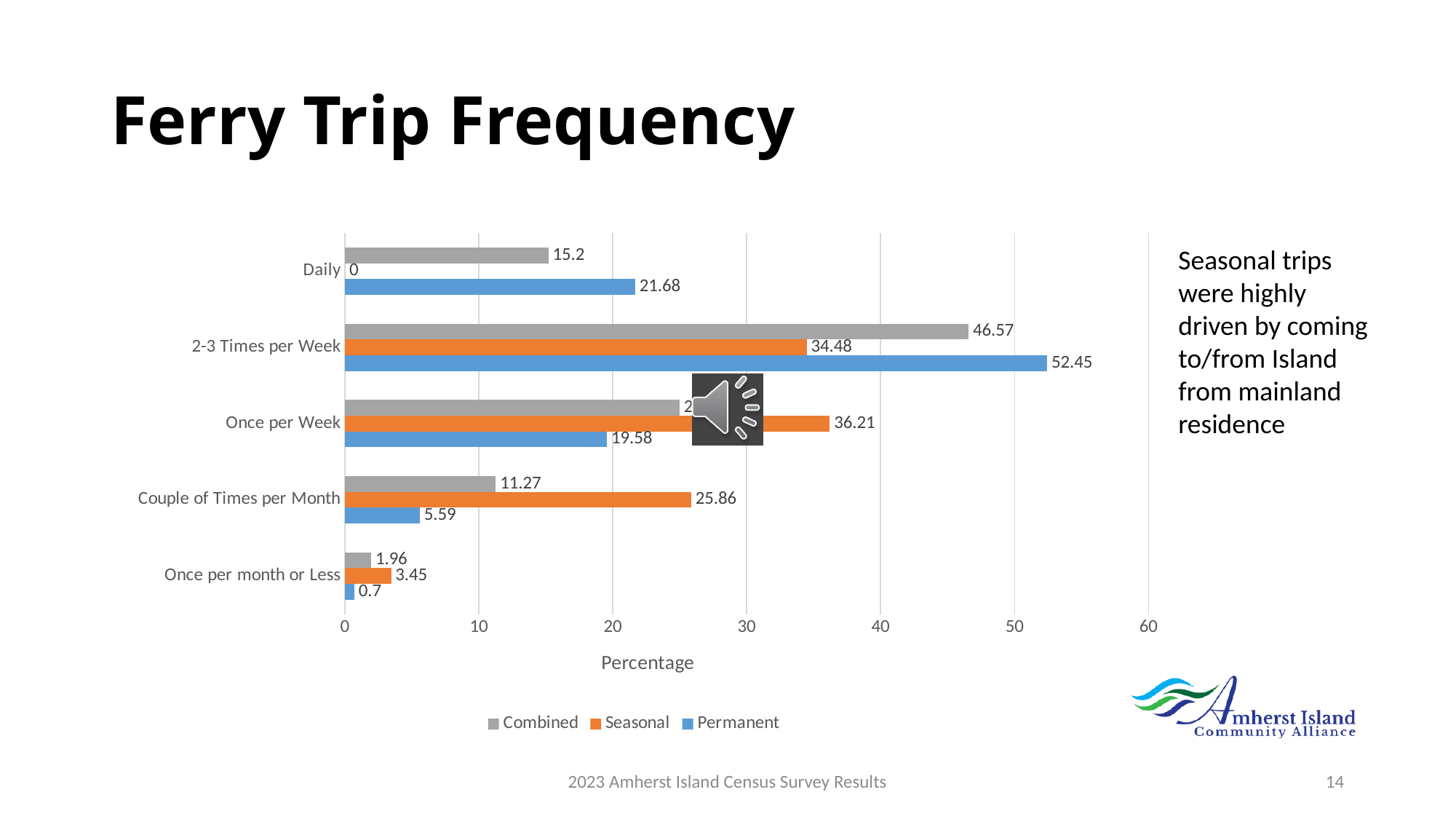
What is the Seasonal value for Once per Week? 36.21 What is the difference between the Permanent and Seasonal values for 2-3 Times per Week? 17.97 Which category has the lowest Seasonal value? Daily What is the Permanent value for 2-3 Times per Week? 52.45 How many categories are shown on the chart? 5 What is the Combined value for Couple of Times per Month? 11.27 Which category has the highest Permanent value? 2-3 Times per Week Is the Combined value for Once per Week greater or less than 20? greater How many series does the legend list? 3 What kind of chart is shown on the slide? bar chart What is the Seasonal value for Daily? 0 Which is larger for Couple of Times per Month, the Seasonal value or the Permanent value? Seasonal